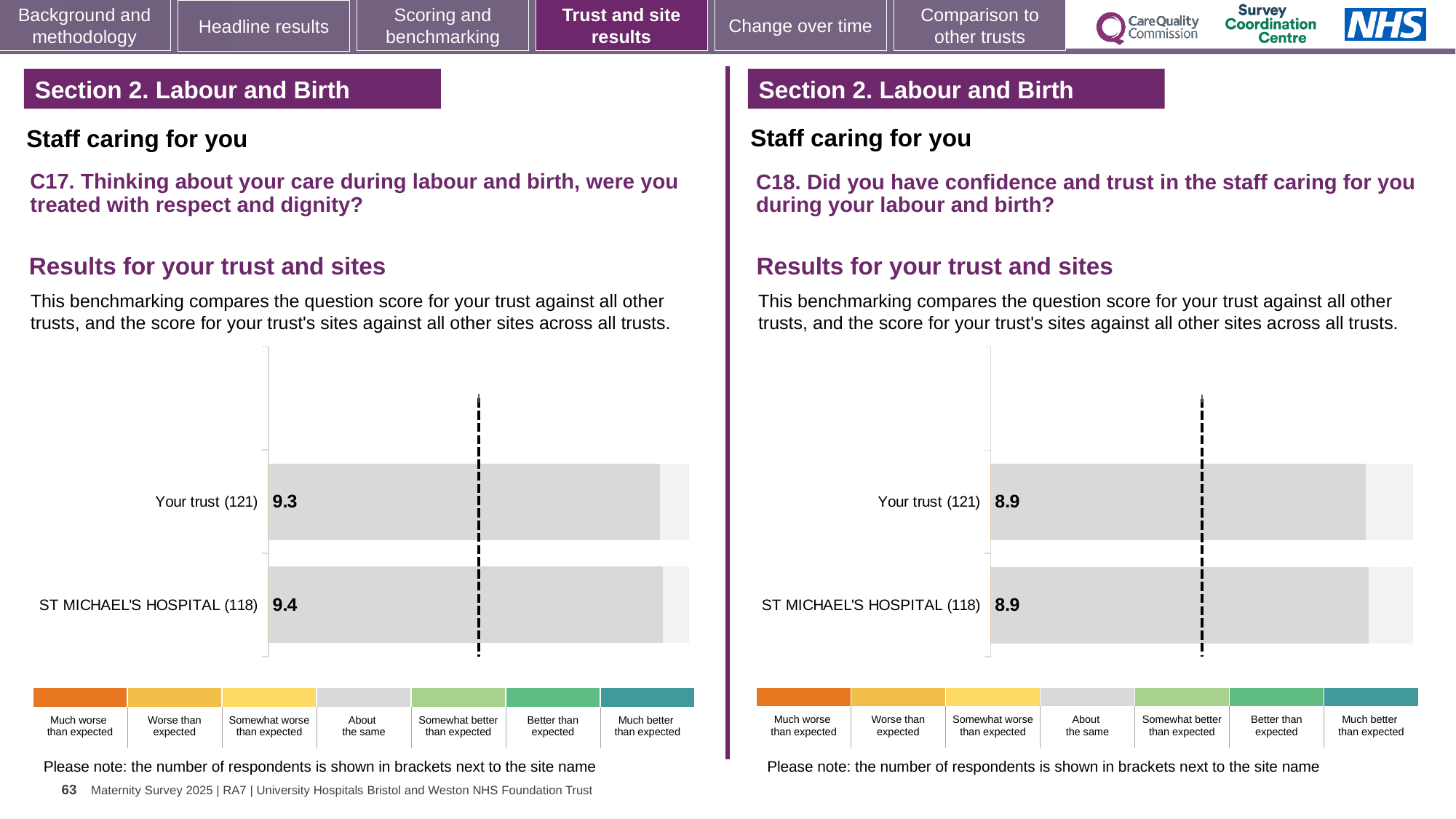
How many bars are plotted in the right chart (C18)? 2 What type of chart is used on the left side of the slide (C17)? Bar chart How many bars are plotted in the left chart (C17)? 2 In the left chart (C17), what is the score for ST MICHAEL'S HOSPITAL (118)? 9.4 How many respondents are shown in brackets for ST MICHAEL'S HOSPITAL in the right chart (C18)? 118 In the right chart (C18), what is the score for ST MICHAEL'S HOSPITAL (118)? 8.9 In the left chart (C17), which has the higher score, Your trust or ST MICHAEL'S HOSPITAL? ST MICHAEL'S HOSPITAL In the right chart (C18), what is the difference between the Your trust score and the ST MICHAEL'S HOSPITAL score? 0 How many categories does the colour key below each chart list, from 'Much worse than expected' to 'Much better than expected'? 7 In the right chart (C18), what is the score for Your trust (121)? 8.9 In the left chart (C17), what is the difference between the ST MICHAEL'S HOSPITAL score and the Your trust score? 0.1 In the left chart (C17), what is the score for Your trust (121)? 9.3